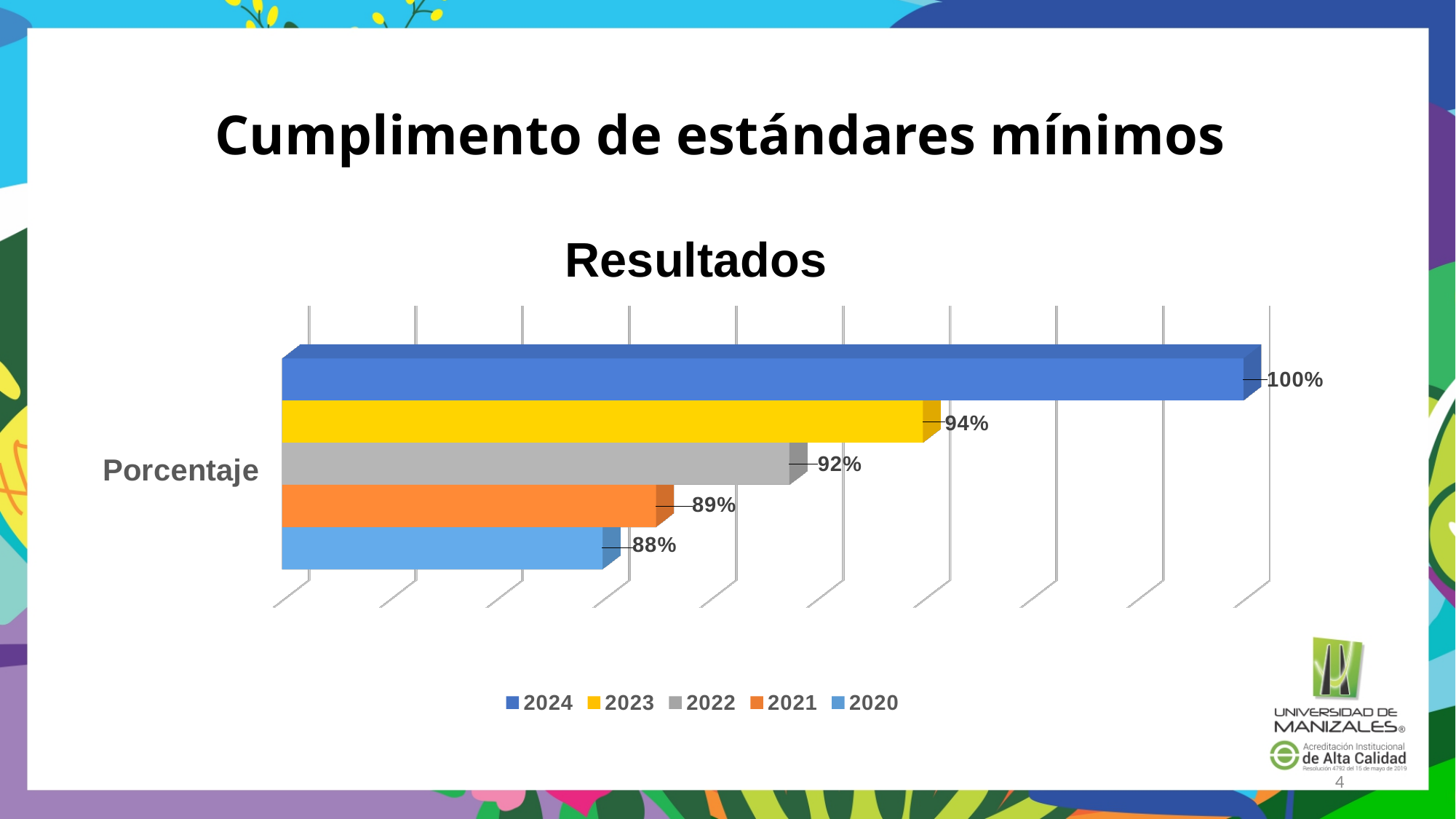
Which year has the highest value in the Resultados chart? 2024 Which year has the lowest value in the Resultados chart? 2020 What is the value for 2022 in the Resultados chart? 92% What is the value for 2023 in the Resultados chart? 94% What is the value for 2021 in the Resultados chart? 89% What is the value for 2020 in the Resultados chart? 88% What is the value for 2024 in the Resultados chart? 100% What is the difference between the values for 2024 and 2020? 12% What kind of chart is shown on the slide? Bar chart What is the title of the chart? Resultados Which is larger, the value for 2023 or the value for 2022? 2023 How many series does the legend list? 5